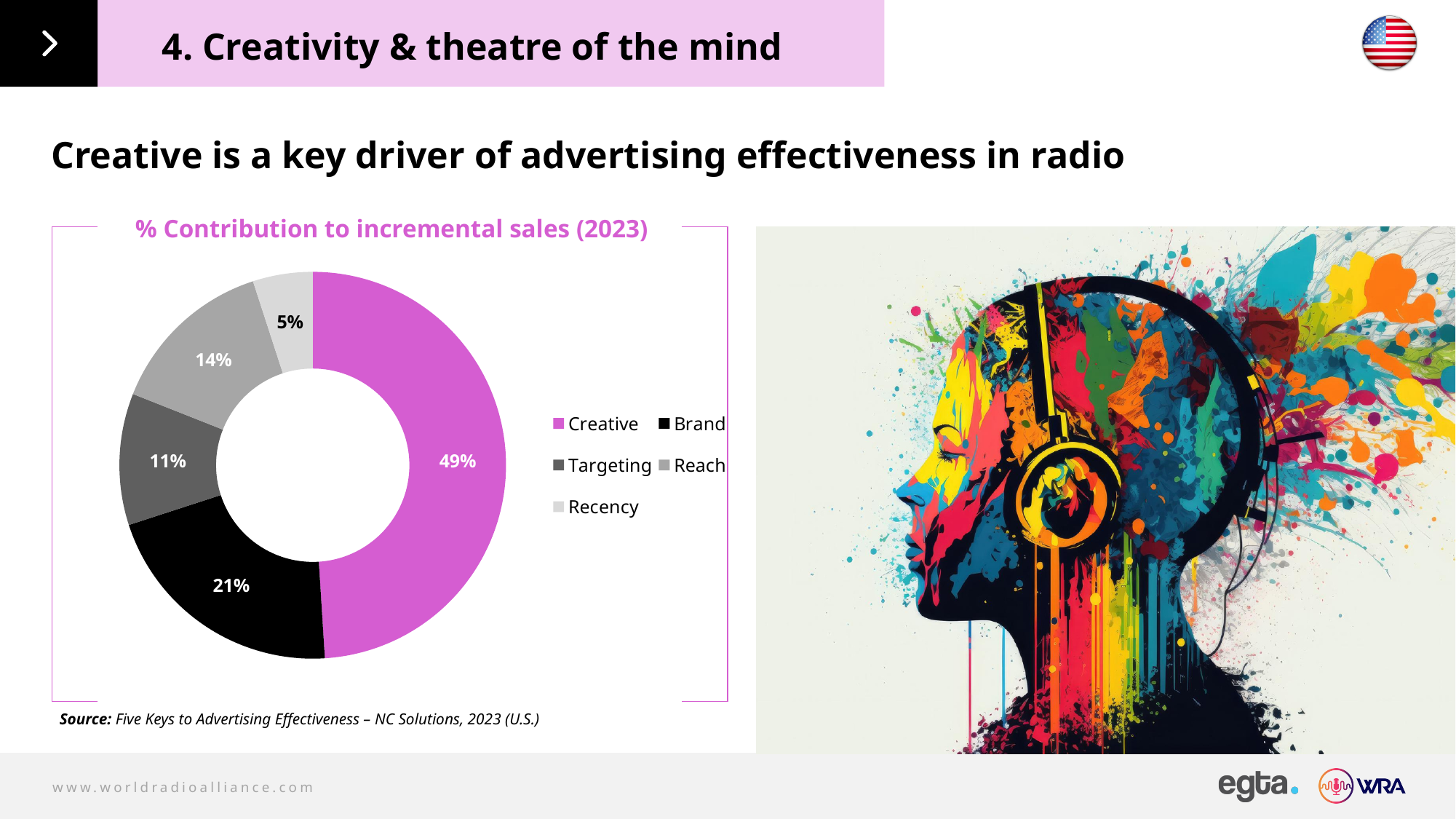
What is the value for Creative in the % Contribution to incremental sales (2023) chart? 49% What is the value for Brand in the chart? 21% What is the value for Targeting in the chart? 11% What is the value for Recency in the chart? 5% What is the value for Reach in the chart? 14% Which is larger, the value for Reach or the value for Targeting? Reach Which category has the smallest share in the chart? Recency What is the title of the chart? % Contribution to incremental sales (2023) How many categories are shown in the chart? 5 Which category has the largest share in the chart? Creative What is the difference between the values for Creative and Brand? 28% What kind of chart is shown on the slide? Doughnut (pie) chart